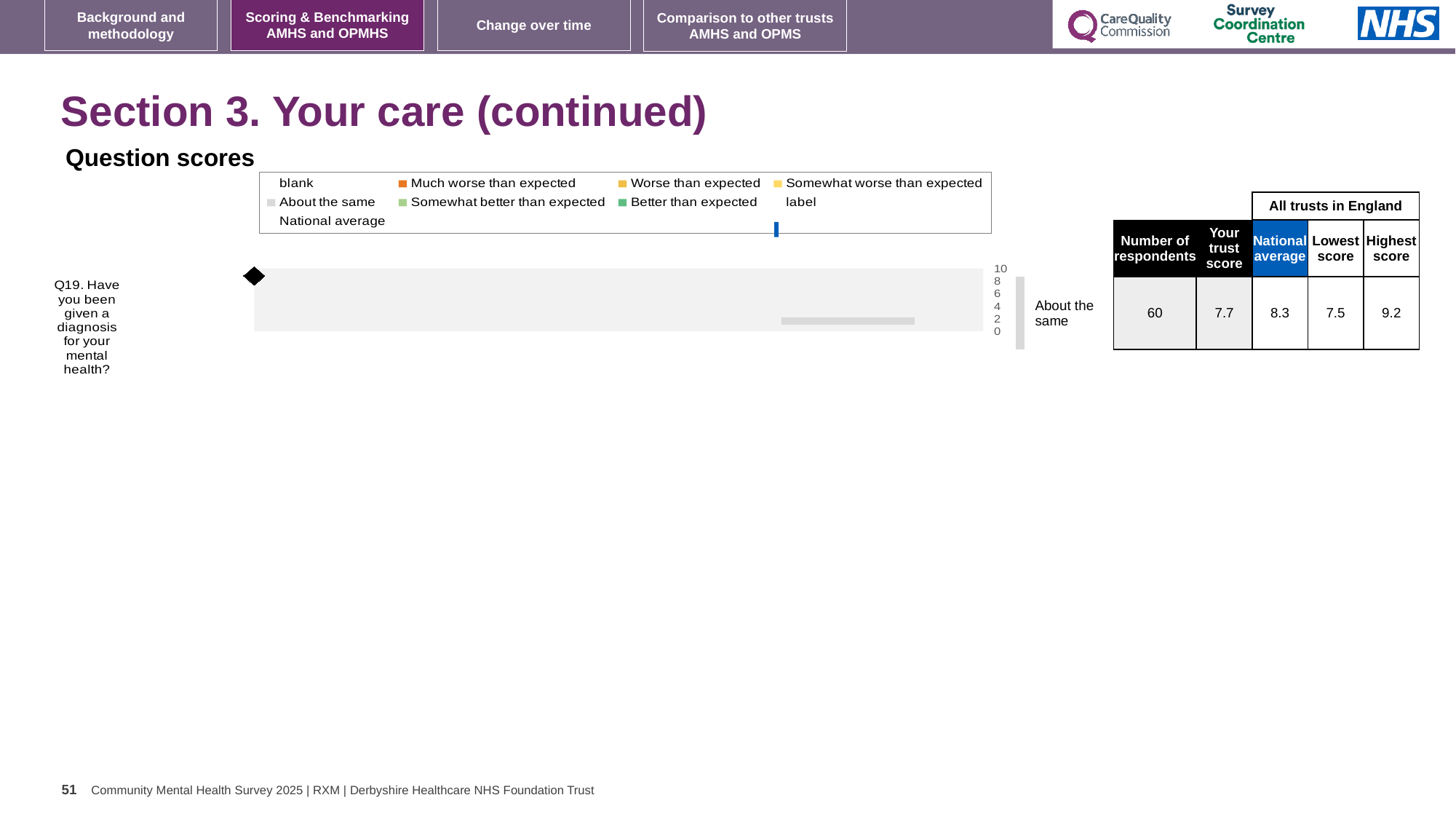
What kind of chart is shown under the heading 'Question scores'? bar chart How many questions are plotted in the 'Question scores' chart? 1 What is the difference between the national average and the trust score for Q19? 0.6 What colour does the legend use for 'About the same'? grey Which benchmark category is shown for Q19 in the 'Question scores' chart? About the same What is the trust score for Q19 shown in the table next to the chart? 7.7 What is the highest score across all trusts in England for Q19? 9.2 What is the national average for Q19 shown in the table next to the chart? 8.3 How many respondents answered Q19 according to the table next to the chart? 60 What is the lowest score across all trusts in England for Q19? 7.5 For Q19, which is larger: the trust score or the national average? national average What is the difference between the highest score and the lowest score for Q19? 1.7